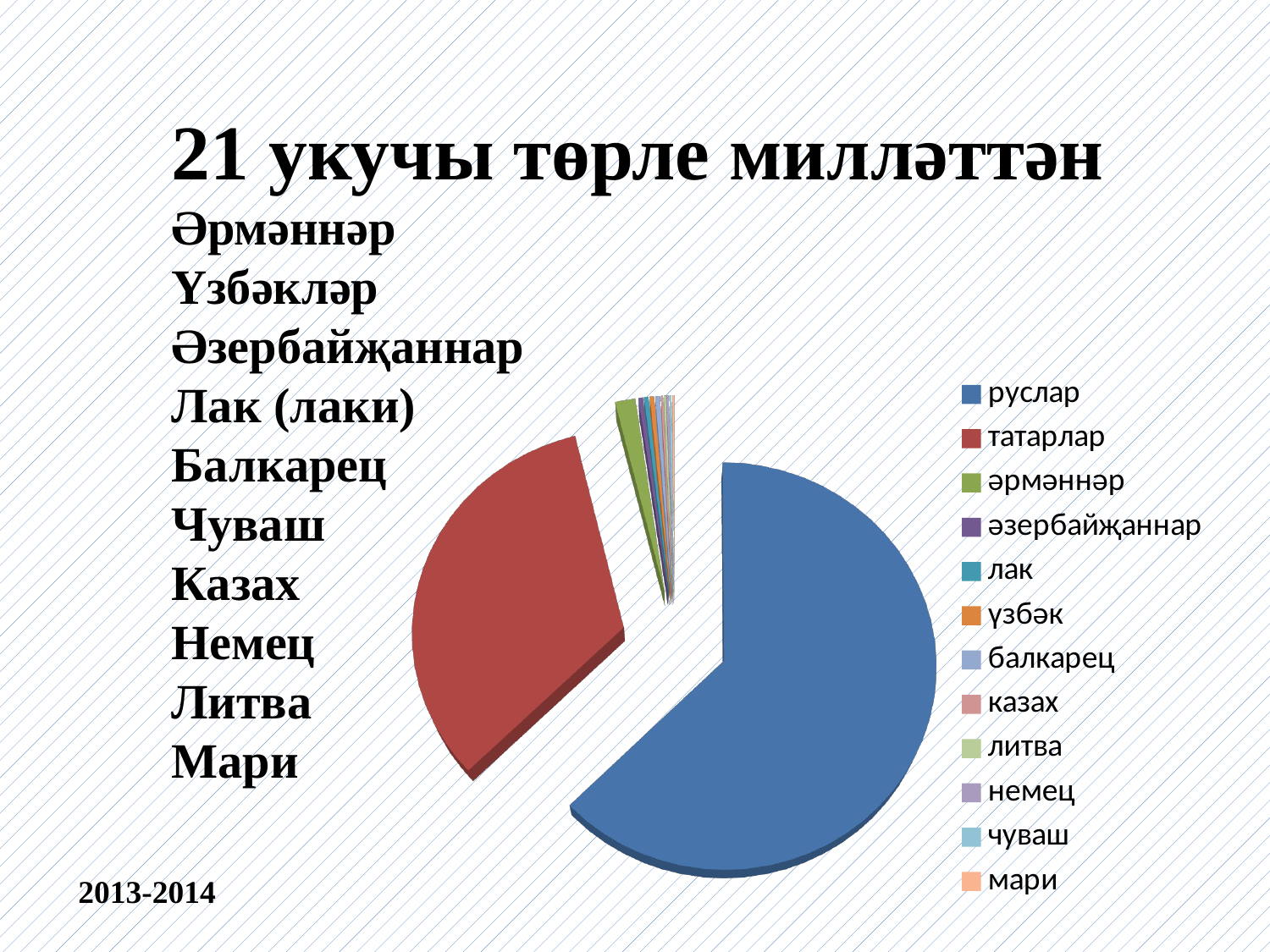
Which category has the largest slice of the pie? руслар Which category is listed first in the legend? руслар What kind of chart is shown on the slide? pie chart What colour is the slice for татарлар? red Which slice is larger, руслар or татарлар? руслар What colour is the slice for руслар? blue Which slice is larger, әрмәннәр or руслар? руслар Which slice is larger, татарлар or әрмәннәр? татарлар Which category has the second-largest slice of the pie? татарлар How many categories does the chart's legend list? 12